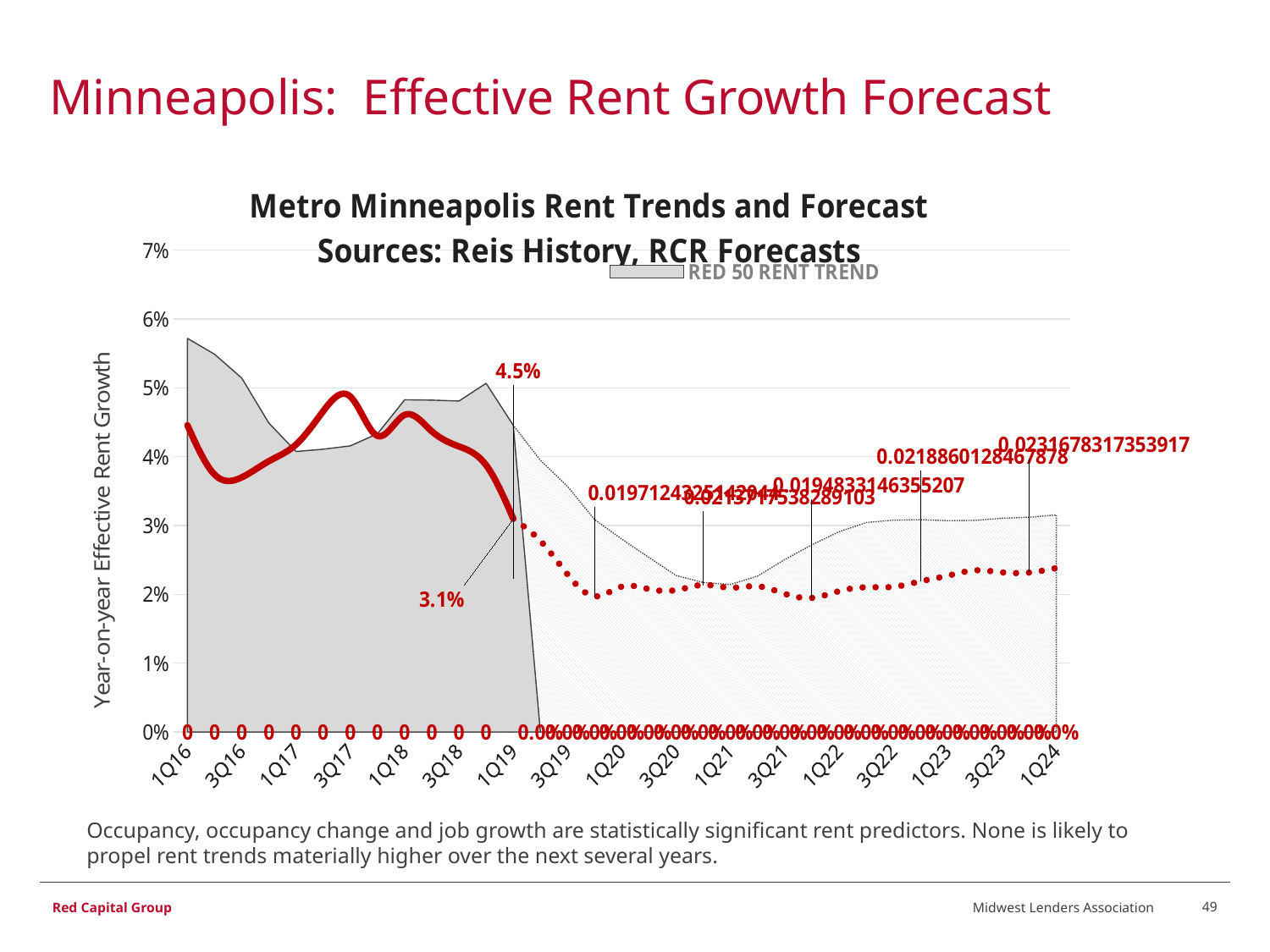
At 1Q19, which is larger: the RED 50 RENT TREND value or the red line value? RED 50 RENT TREND (4.5%) Does the red line rise or fall between 1Q18 and 1Q19? fall How many quarter labels are shown on the x axis? 17 What is the difference between the 4.5% and 3.1% values labeled at 1Q19? 1.4% Is the RED 50 RENT TREND value at 1Q16 greater or less than 5%? greater What value is labeled on the RED 50 RENT TREND area at 1Q19? 4.5% What value is labeled on the red line at 1Q19? 3.1% Is the red line value at 3Q16 greater or less than 4%? less